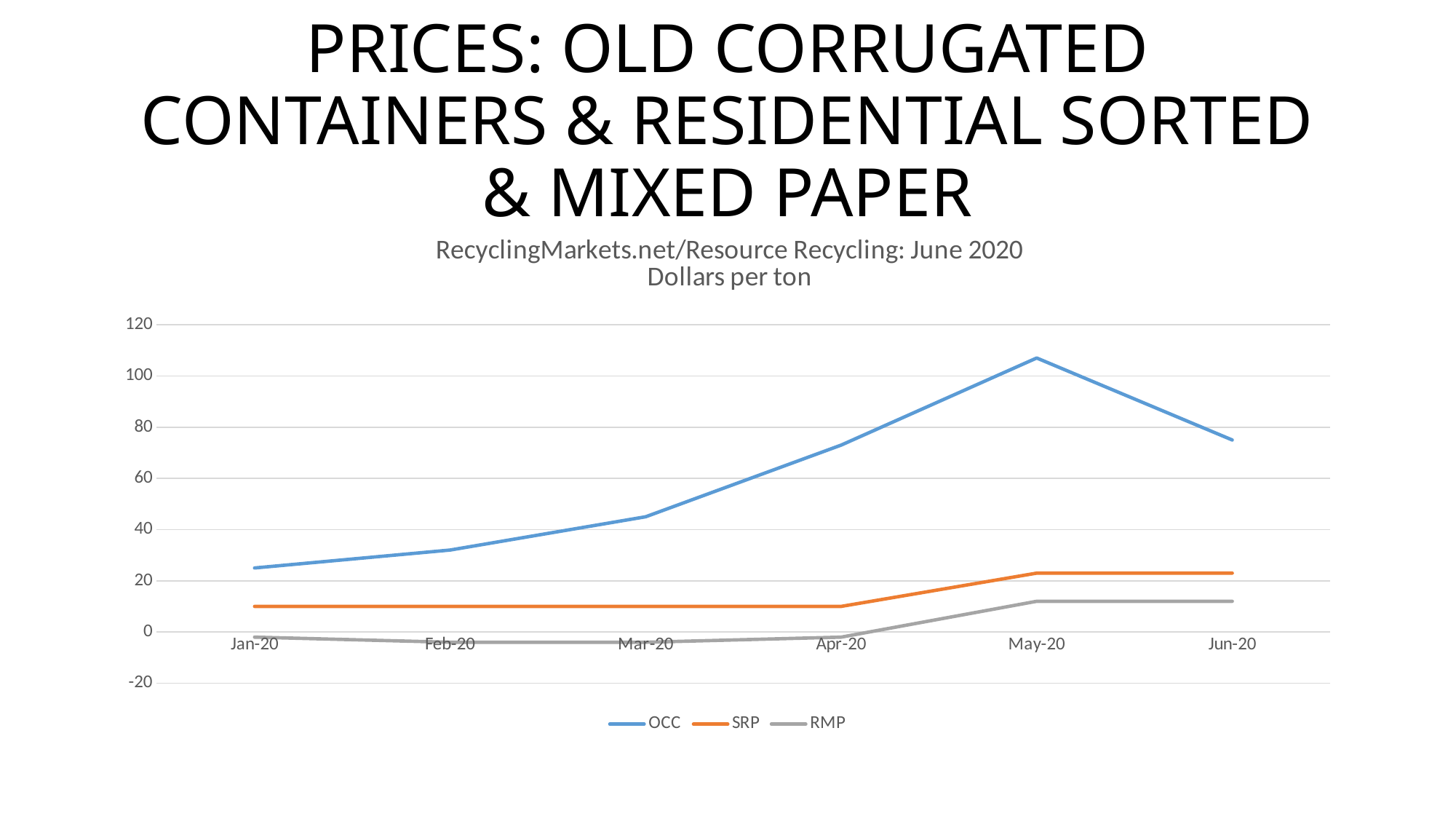
Which series has the larger value in May-20, OCC or SRP? OCC How many series does the legend list? 3 What unit is given in the chart subtitle? Dollars per ton In which month does the OCC series reach its highest value? May-20 What kind of chart is shown on the slide? line chart Is the value for OCC in Jan-20 greater or less than 40? less Does the OCC series rise or fall from Jan-20 to May-20? rise In which month is the OCC series at its lowest value? Jan-20 Is the value for OCC in May-20 greater or less than 100? greater Is the value for RMP in Feb-20 greater or less than 0? less How many months are plotted along the x axis? 6